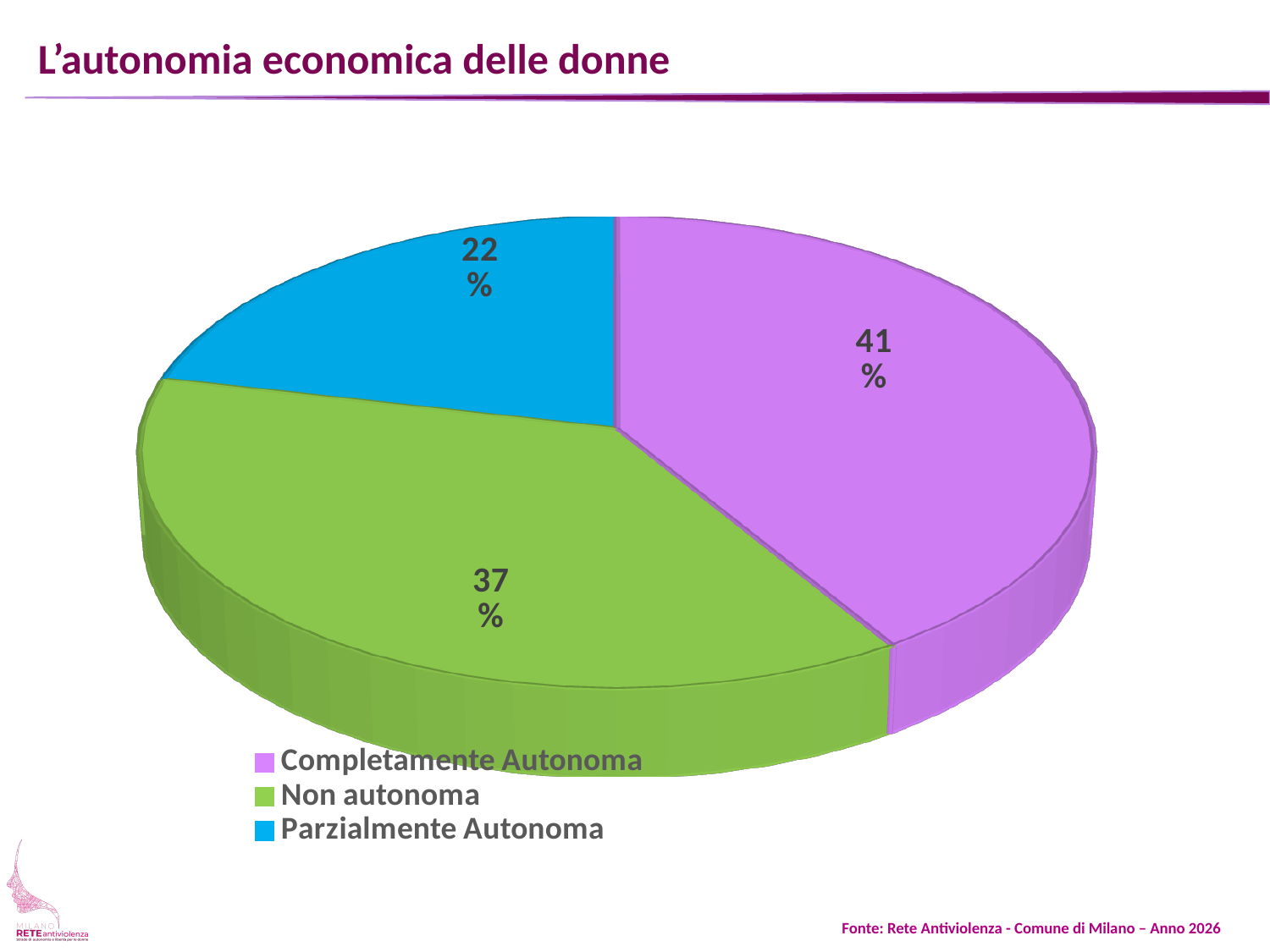
How many categories does the pie chart show? 3 What is the difference in percentage points between Non autonoma and Parzialmente Autonoma? 15 What share of the pie is labelled Parzialmente Autonoma? 22% Which colour represents Parzialmente Autonoma in the legend? Blue Which is larger, the share for Non autonoma or the share for Parzialmente Autonoma? Non autonoma Which category has the smallest slice of the pie? Parzialmente Autonoma What is the difference in percentage points between Completamente Autonoma and Non autonoma? 4 What share of the pie is labelled Non autonoma? 37% Which category has the largest slice of the pie? Completamente Autonoma What share of the pie is labelled Completamente Autonoma? 41% What is the title of the slide containing the chart? L'autonomia economica delle donne What type of chart is shown on the slide? Pie chart